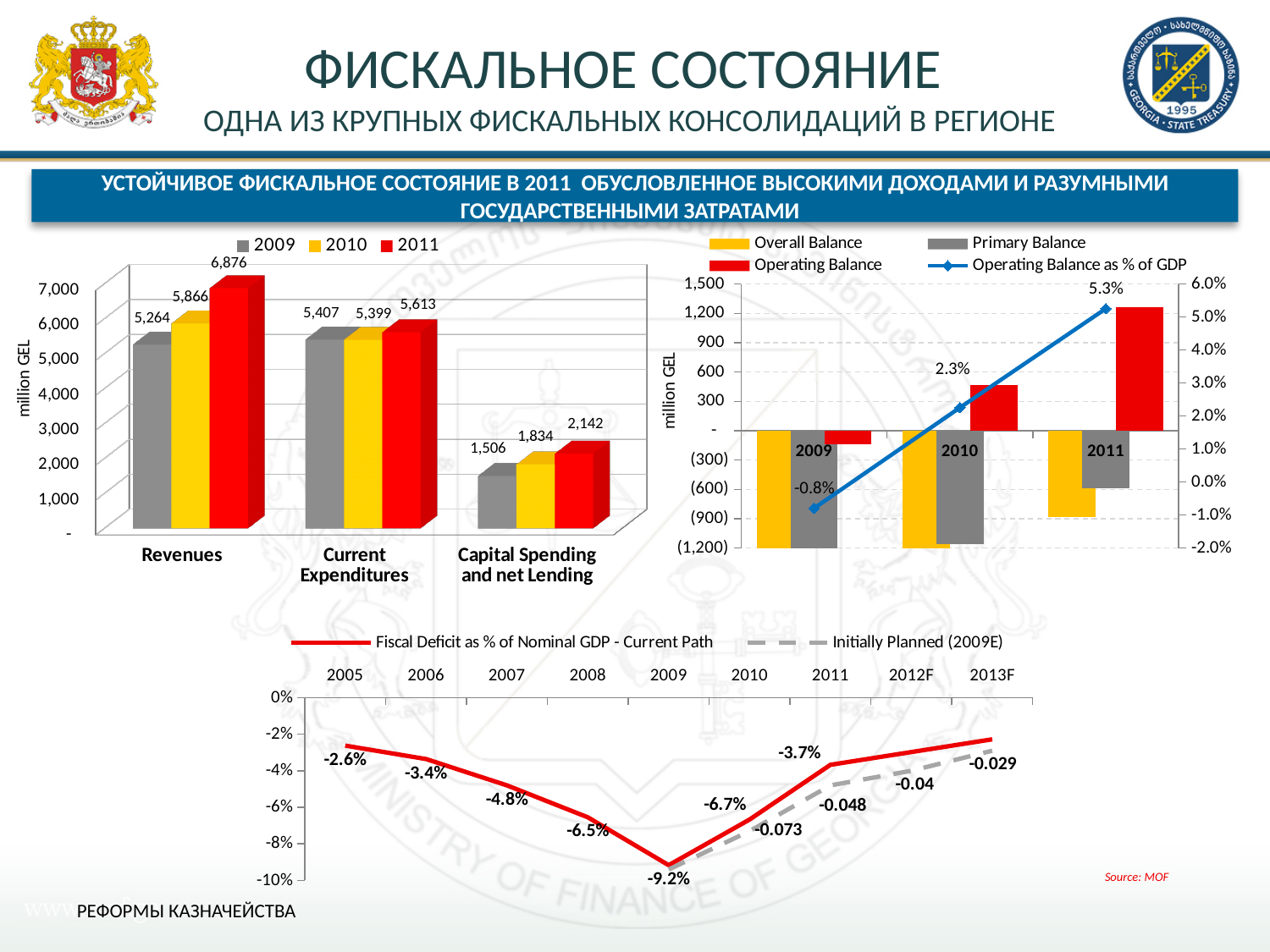
In the top-left bar chart, how many series does the legend list? 3 In the top-right chart, is the Operating Balance bar for 2011 greater or less than 900 million GEL? greater In the top-left bar chart, do the Capital Spending and net Lending values rise or fall from 2009 to 2011? rise In the top-right chart, what is the Operating Balance as % of GDP in 2011? 5.3% In the top-left bar chart, which is larger: Current Expenditures in 2009 or Current Expenditures in 2010? Current Expenditures in 2009 In the top-left bar chart, what is the value for Capital Spending and net Lending in 2009? 1,506 In the bottom line chart, what is the Fiscal Deficit as % of Nominal GDP (Current Path) in 2009? -9.2% In the bottom line chart, which year has the lowest Fiscal Deficit as % of Nominal GDP on the Current Path line? 2009 In the top-left bar chart, what is the difference between Revenues in 2011 and Revenues in 2010? 1,010 In the top-left bar chart, what is the value for Revenues in 2011? 6,876 In the top-right chart, what is the Operating Balance as % of GDP in 2009? -0.8% In the bottom line chart, what is the Initially Planned (2009E) value for 2013F? -0.029